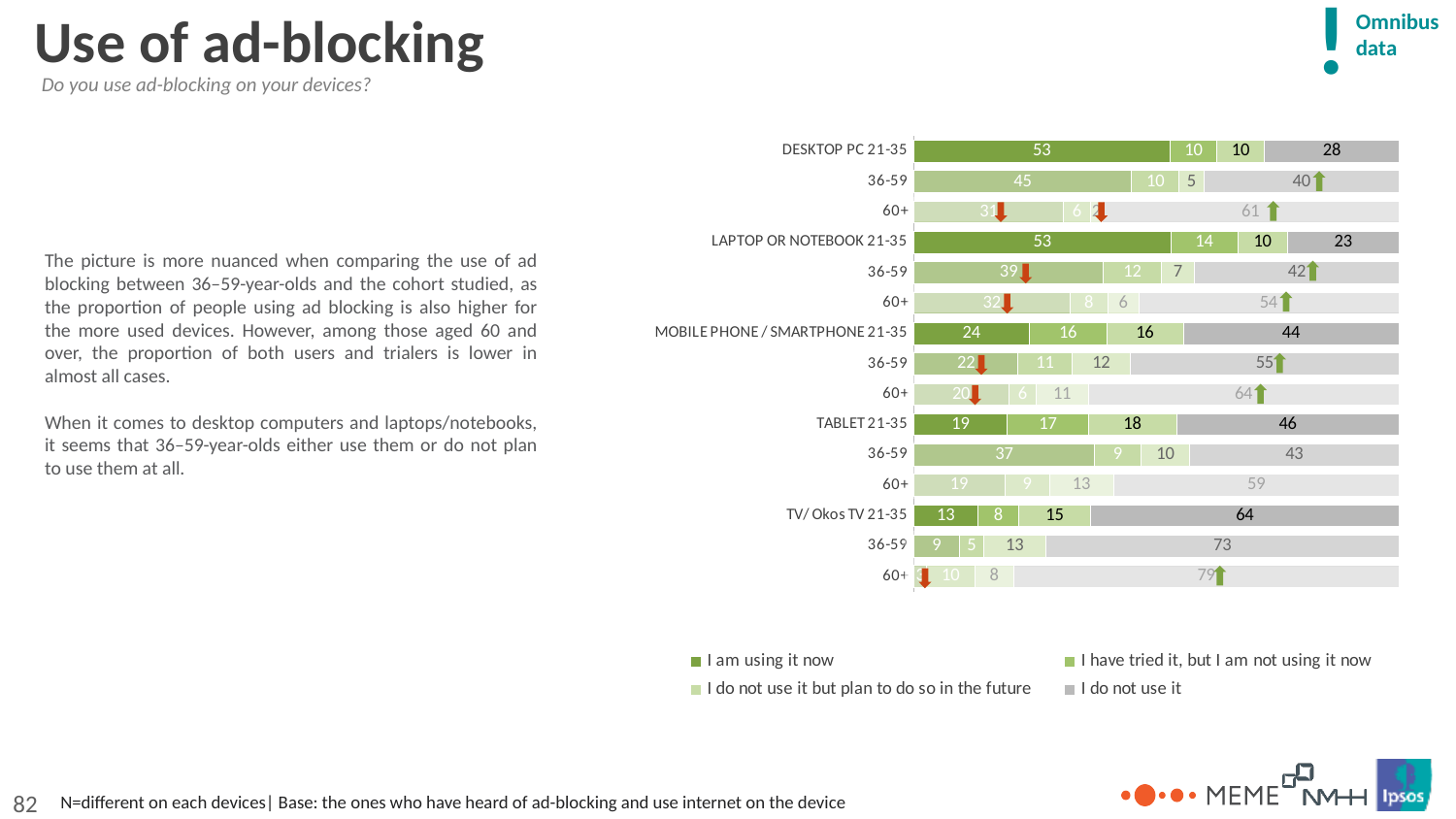
Which category has the lowest value for 'I do not use it'? Laptop or notebook 21-35 What kind of chart is shown on the slide? Stacked bar chart Which is larger: the 'I am using it now' value for Tablet 36-59 or for Mobile phone / smartphone 21-35? Tablet 36-59 Which category has the highest value for 'I do not use it'? TV/Okos TV 60+ What is the value for 'I have tried it, but I am not using it now' for Laptop or notebook 21-35? 14 How many series does the legend list? 4 What is the value for 'I am using it now' for Desktop PC 21-35? 53 What is the difference between the 'I am using it now' values for Desktop PC 21-35 and Desktop PC 36-59? 8 What is the value for 'I do not use it' for TV/Okos TV 36-59? 73 How many bars (category rows) are plotted in the chart? 15 What is the total of the stacked bar for Mobile phone / smartphone 21-35? 100 What is the value for 'I do not use it but plan to do so in the future' for Tablet 21-35? 18